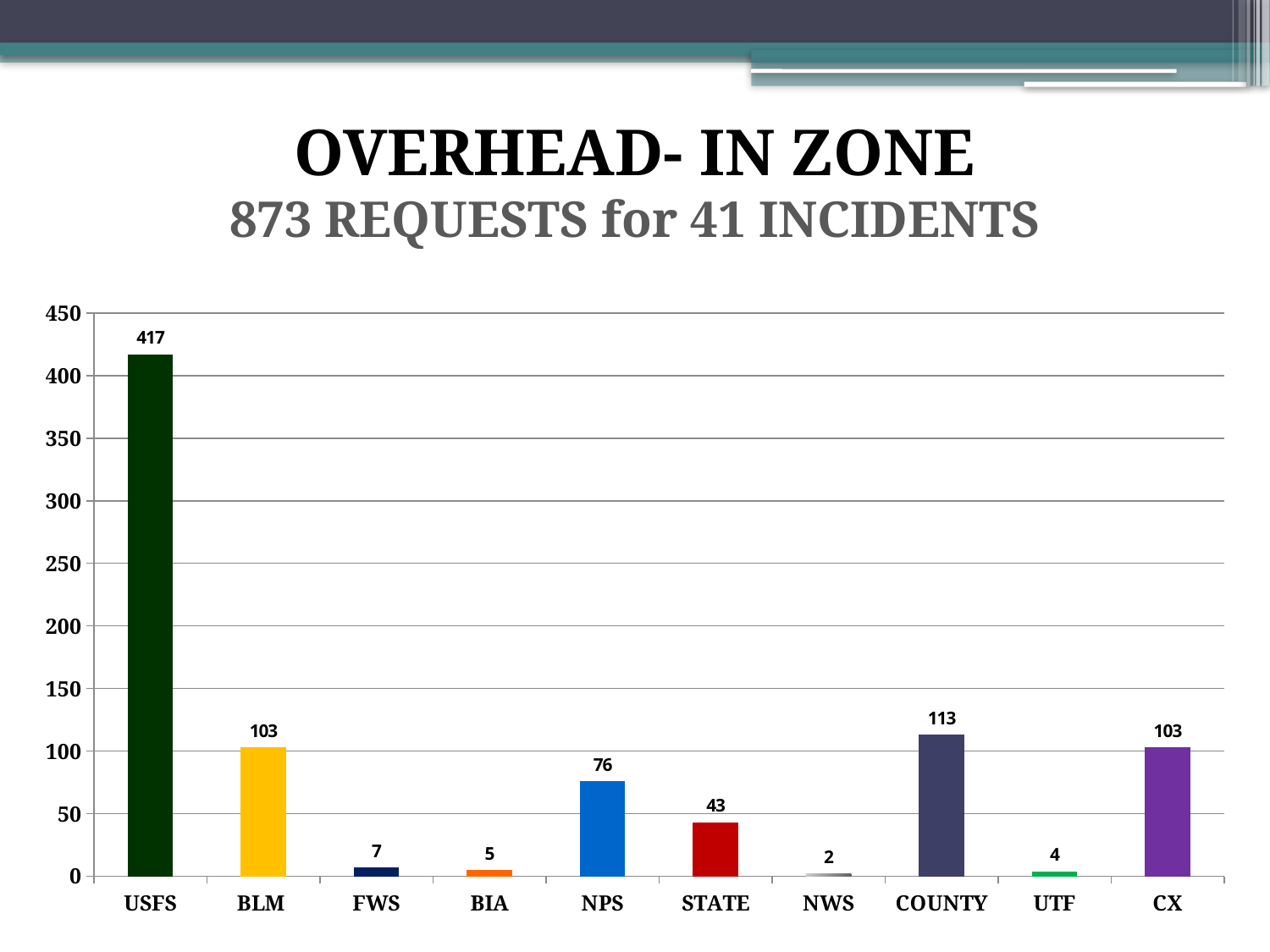
What is the value for COUNTY? 113 Which category has the lowest value? NWS What is the value for USFS? 417 Is the value for USFS greater or less than 400? greater How many categories are shown on the x axis? 10 What is the title of the chart on the slide? OVERHEAD- IN ZONE Which category has the highest value? USFS What is the difference between the values for USFS and COUNTY? 304 What is the difference between the values for NPS and STATE? 33 Which is larger, the value for COUNTY or the value for BLM? COUNTY What is the value for STATE? 43 What kind of chart is shown on the slide? bar chart